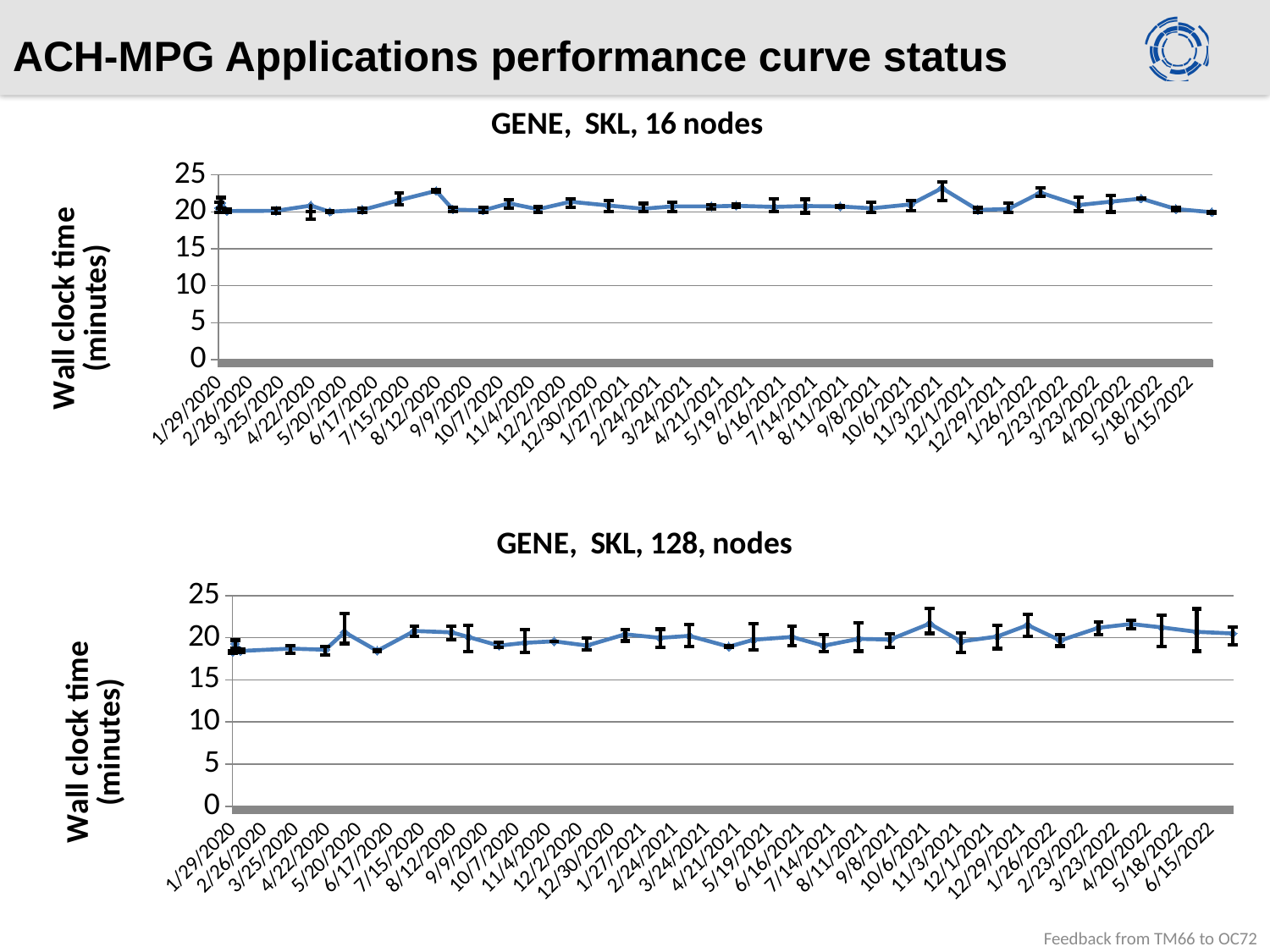
What is the y-axis label of the 'GENE, SKL, 128, nodes' chart? Wall clock time (minutes) In the 'GENE, SKL, 16 nodes' chart, is the value for 3/25/2020 greater or less than 15? greater What kind of chart is the 'GENE, SKL, 16 nodes' chart? line chart In the 'GENE, SKL, 16 nodes' chart, is the value for 8/12/2020 greater or less than 25? less What is the title of the top chart on the slide? GENE, SKL, 16 nodes In the 'GENE, SKL, 128, nodes' chart, is the value for 4/20/2022 greater or less than 25? less In the 'GENE, SKL, 16 nodes' chart, which is larger, the value for 11/3/2021 or the value for 12/1/2021? 11/3/2021 In the 'GENE, SKL, 128, nodes' chart, which is larger, the value for 1/29/2020 or the value for 7/15/2020? 7/15/2020 In the 'GENE, SKL, 16 nodes' chart, how many dates are shown on the x axis? 32